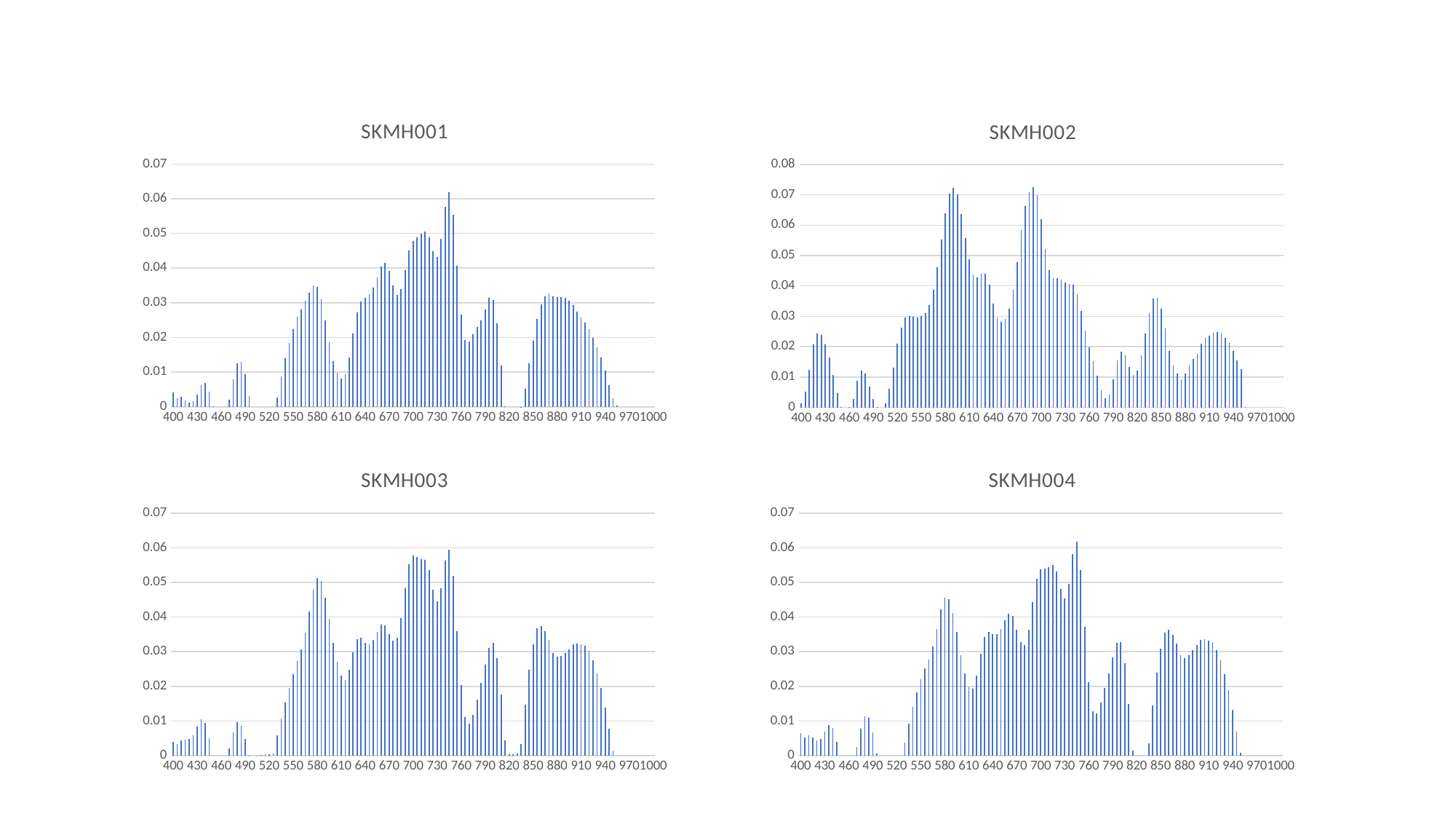
How many charts are shown on the slide? 4 In the SKMH004 chart, is the tallest bar greater or less than 0.05? greater In the SKMH001 chart, is the tallest bar greater or less than 0.05? greater In the SKMH001 chart, which is larger: the peak of bars around 750 or the peak of bars around 880? the peak around 750 In the SKMH004 chart, which is larger: the peak of bars around 750 or the peak of bars around 580? the peak around 750 In the SKMH001 chart, is the value at 880 greater or less than 0.04? less What kind of chart is SKMH001? bar chart Which chart on the slide has a vertical axis that goes up to 0.08? SKMH002 What is the title of the chart in the bottom-right position of the slide? SKMH004